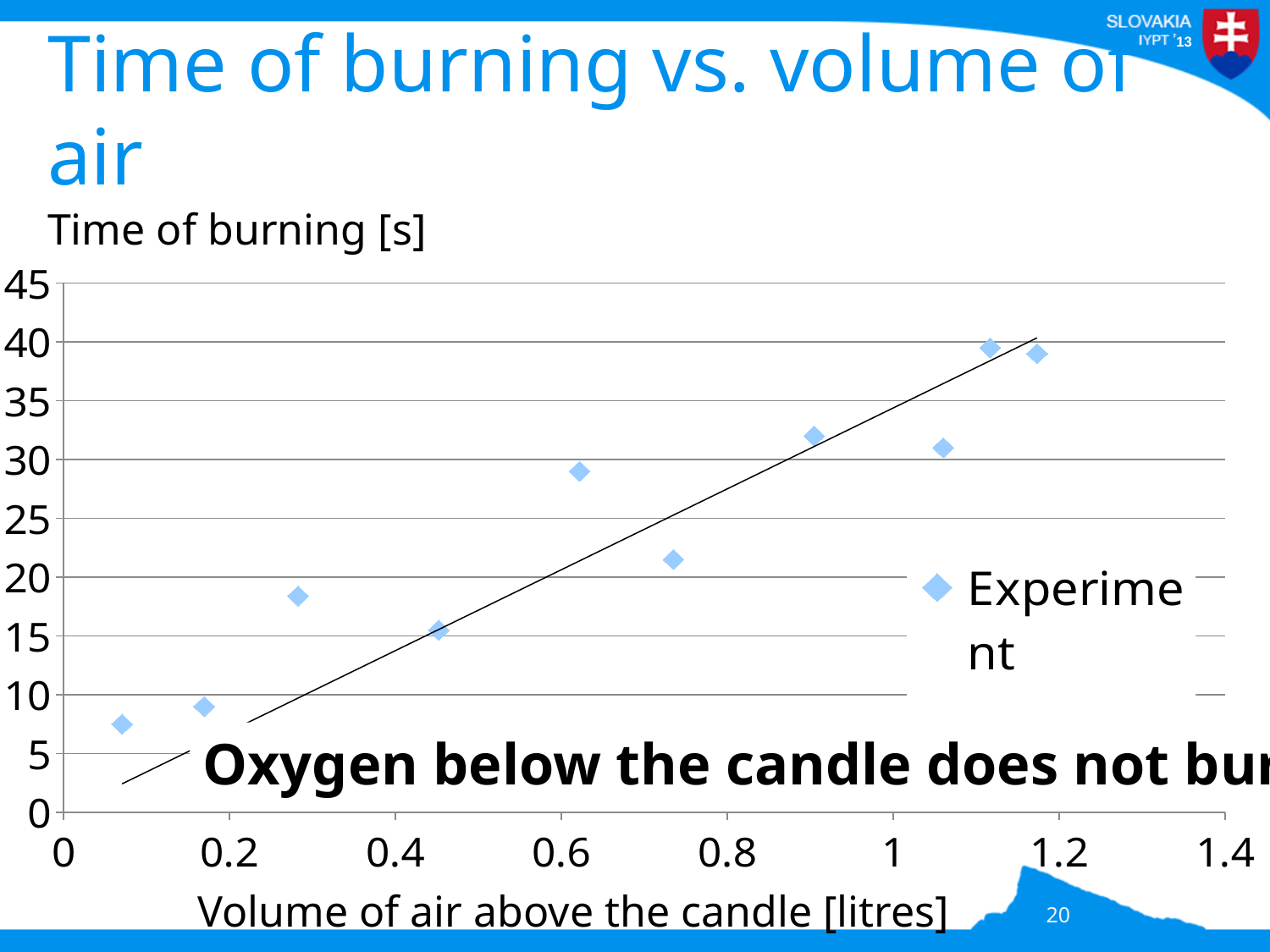
Which point has the longer time of burning: the one at about 0.6 litres or the one at about 0.75 litres? The one at about 0.6 litres How many data points are plotted in the chart? 10 How many series does the legend list? 1 What is the name of the series shown in the legend? Experiment Is the time of burning for the point at about 0.45 litres greater or less than 10 s? greater Overall, does the time of burning rise or fall as the volume of air above the candle increases? Rise What kind of chart is shown on the slide? Scatter chart What is the label of the x axis? Volume of air above the candle [litres] Is the time of burning for the point at about 0.3 litres greater or less than 20 s? less Is the time of burning for the point at about 0.75 litres greater or less than 25 s? less